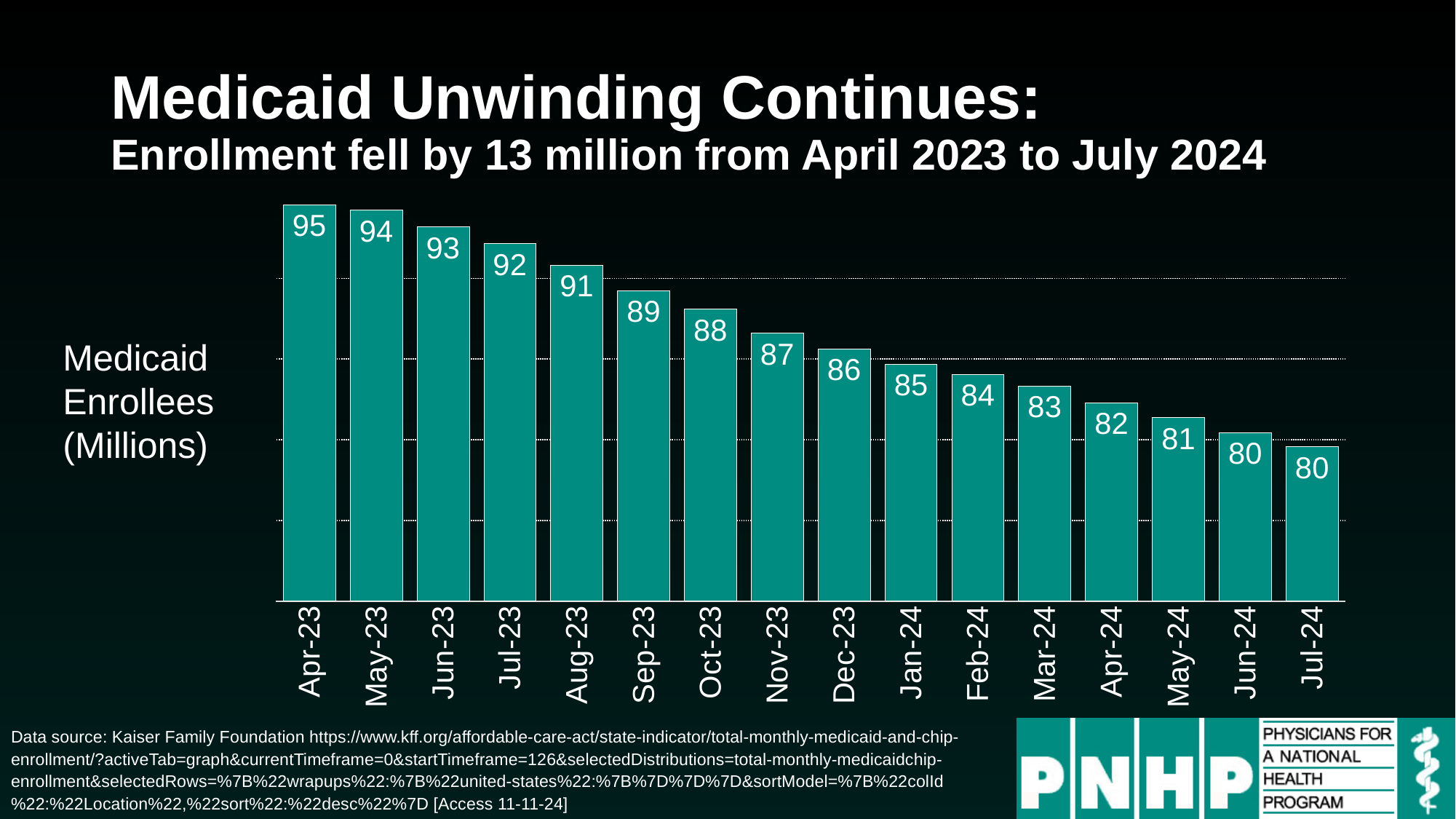
What is the value for Apr-23? 95 What kind of chart is shown on the slide? Bar chart What is the difference between the values for Apr-23 and Jul-24? 15 Which month has the highest value? Apr-23 What is the difference between the values for Aug-23 and Sep-23? 2 What is the value for Jul-24? 80 What is the lowest value shown on the chart? 80 What is the value for Jan-24? 85 Do the values rise or fall from Apr-23 to Jul-24? Fall How many months are shown on the x axis? 16 What is the value for Sep-23? 89 Which is larger, the value for Oct-23 or the value for Mar-24? Oct-23